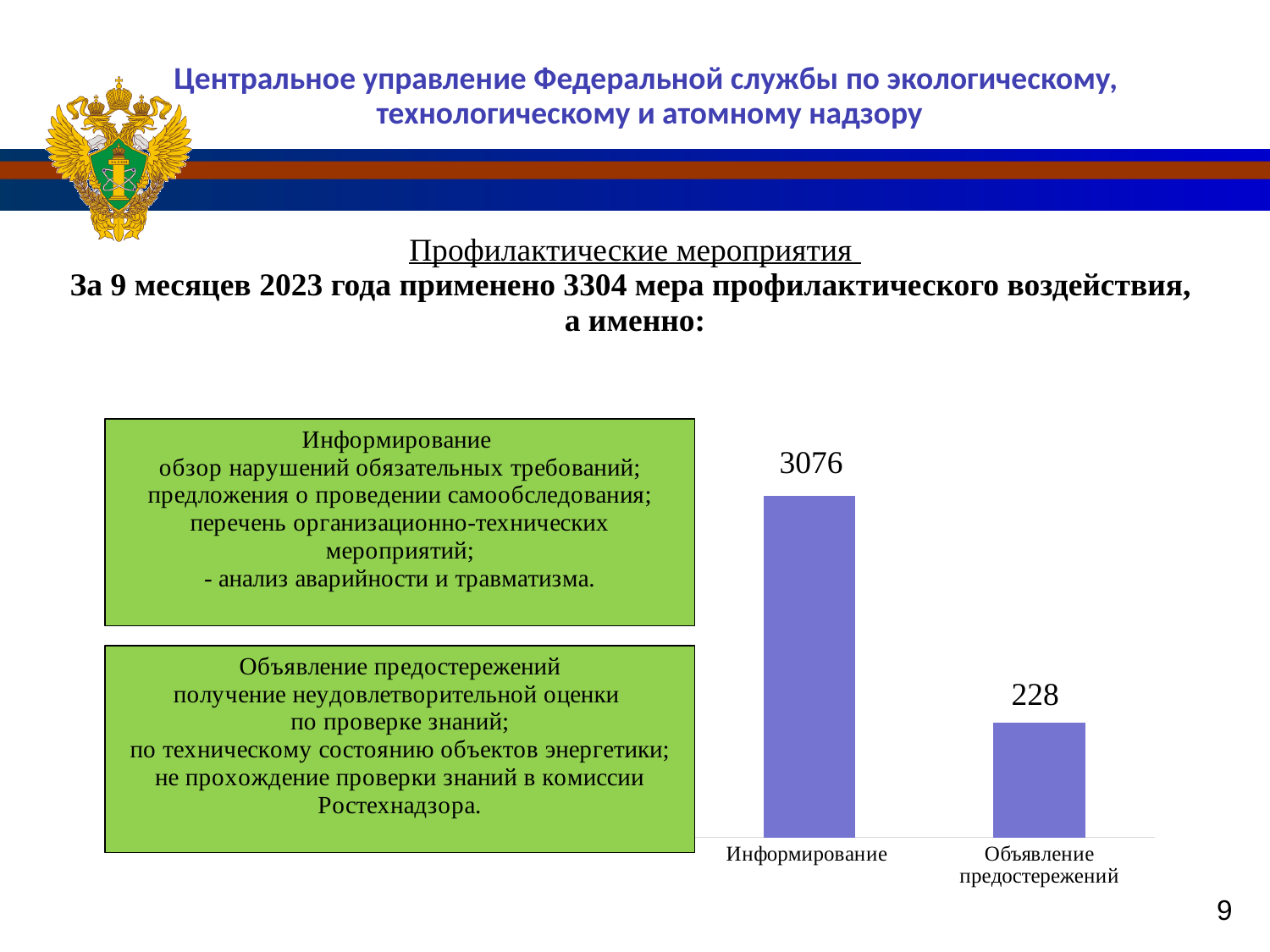
What colour are the bars in the chart? purple Which category has the highest value? Информирование Which is larger, the value for Информирование or the value for Объявление предостережений? Информирование Which category has the lowest value? Объявление предостережений What kind of chart is shown on the slide? bar chart What is the value for Информирование? 3076 What is the value for Объявление предостережений? 228 What is the total of the two values shown in the chart? 3304 How many categories are shown in the chart? 2 What is the difference between the values for Информирование and Объявление предостережений? 2848